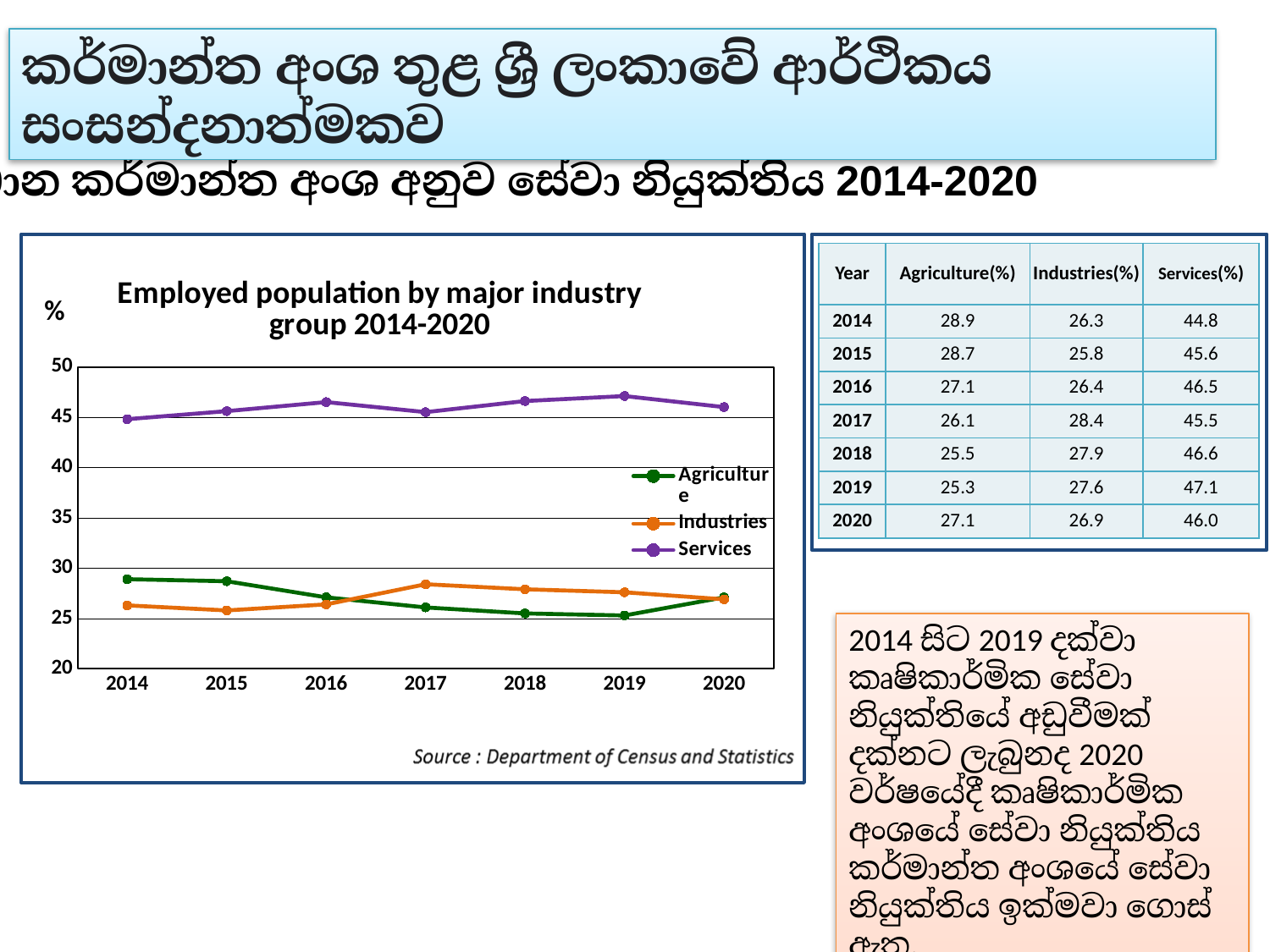
Is the Services value for 2016 greater or less than 45? greater What is the Agriculture value for 2014? 28.9 In 2017, which is larger, Industries or Agriculture? Industries In which year is the Services value highest? 2019 In which year is the Agriculture value lowest? 2019 What is the difference between the Services and Agriculture values in 2014? 15.9 What kind of chart is shown on the slide? line chart What is the title of the chart? Employed population by major industry group 2014-2020 How many years are plotted along the x axis of the chart? 7 How many series does the chart legend list? 3 What is the Services value for 2019? 47.1 Does the Agriculture line rise or fall from 2014 to 2019? fall